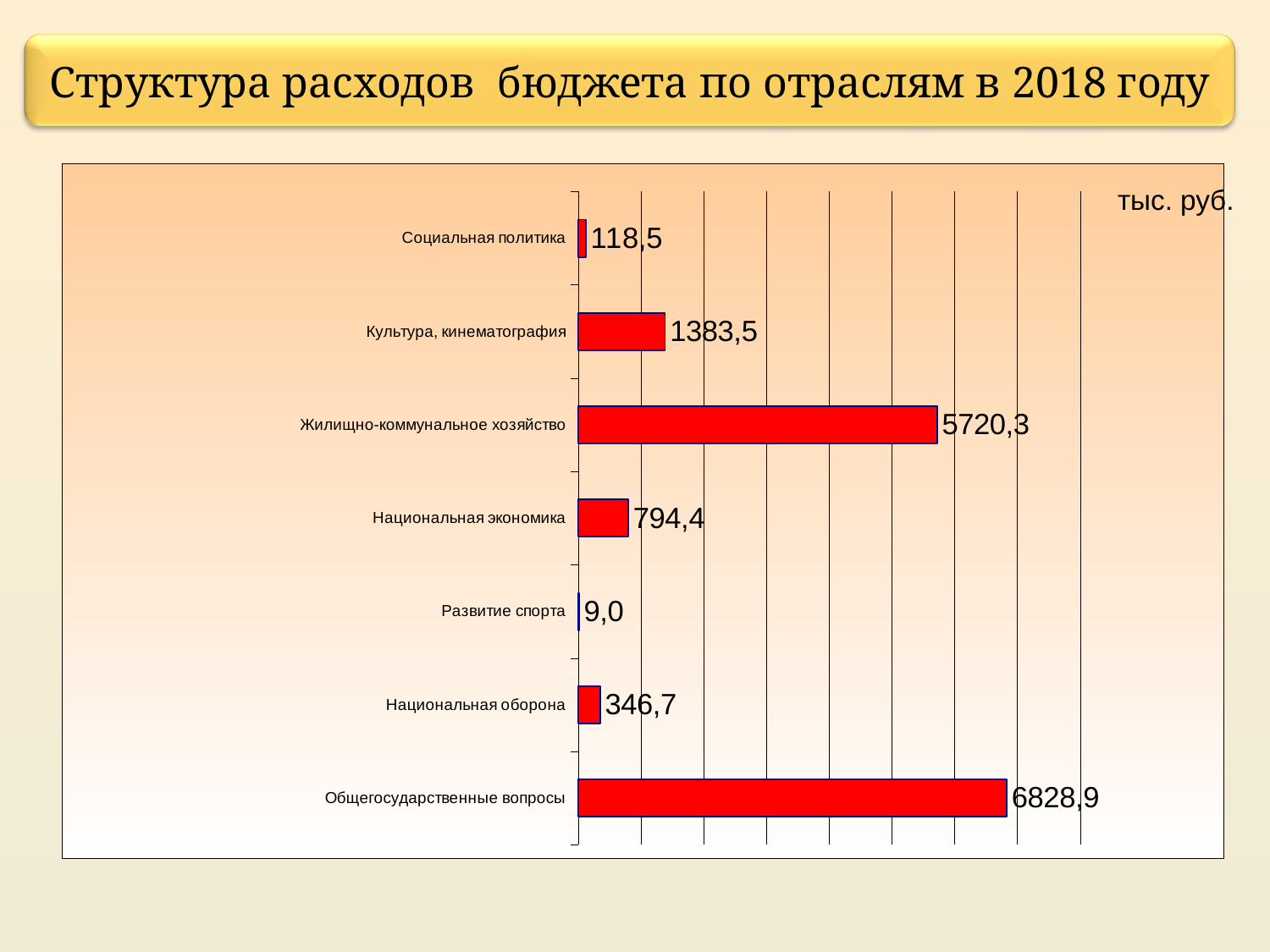
How many categories are shown in the chart? 7 Which category has the lowest value? Развитие спорта What unit is indicated for the values in the chart? тыс. руб. What is the value for Культура, кинематография? 1383,5 What is the value for Развитие спорта? 9,0 What is the difference between the values for Культура, кинематография and Национальная экономика? 589,1 What is the value for Жилищно-коммунальное хозяйство? 5720,3 What is the value for Национальная оборона? 346,7 Which is larger, the value for Национальная экономика or the value for Национальная оборона? Национальная экономика What kind of chart is shown on the slide? Bar chart Which category has the highest value? Общегосударственные вопросы What is the difference between the values for Общегосударственные вопросы and Жилищно-коммунальное хозяйство? 1108,6